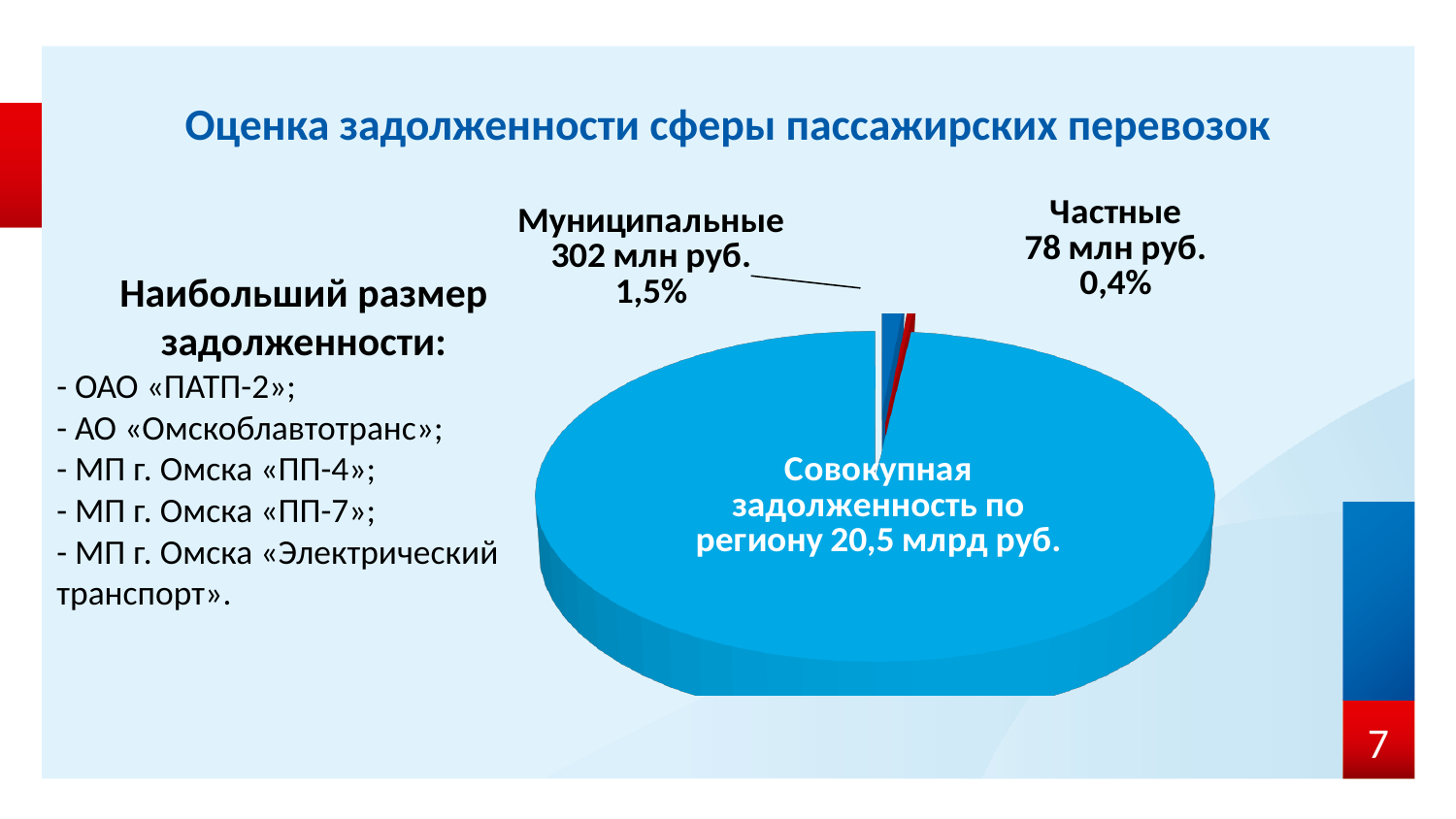
What colour is the Частные slice of the pie? red What kind of chart is shown on the slide? pie chart What is the debt amount for the Муниципальные (municipal) slice? 302 млн руб. What is the debt amount for the Частные (private) slice? 78 млн руб. How many slices does the pie chart have? 3 What is the difference between the Муниципальные debt and the Частные debt? 224 млн руб. Which slice is larger, Муниципальные or Частные? Муниципальные What is the title of the slide containing the pie chart? Оценка задолженности сферы пассажирских перевозок What share of the pie does the Муниципальные slice represent? 1,5% What share of the pie does the Частные slice represent? 0,4% What is the total debt for the region shown on the large slice of the pie? 20,5 млрд руб. Which slice of the pie is the smallest? Частные